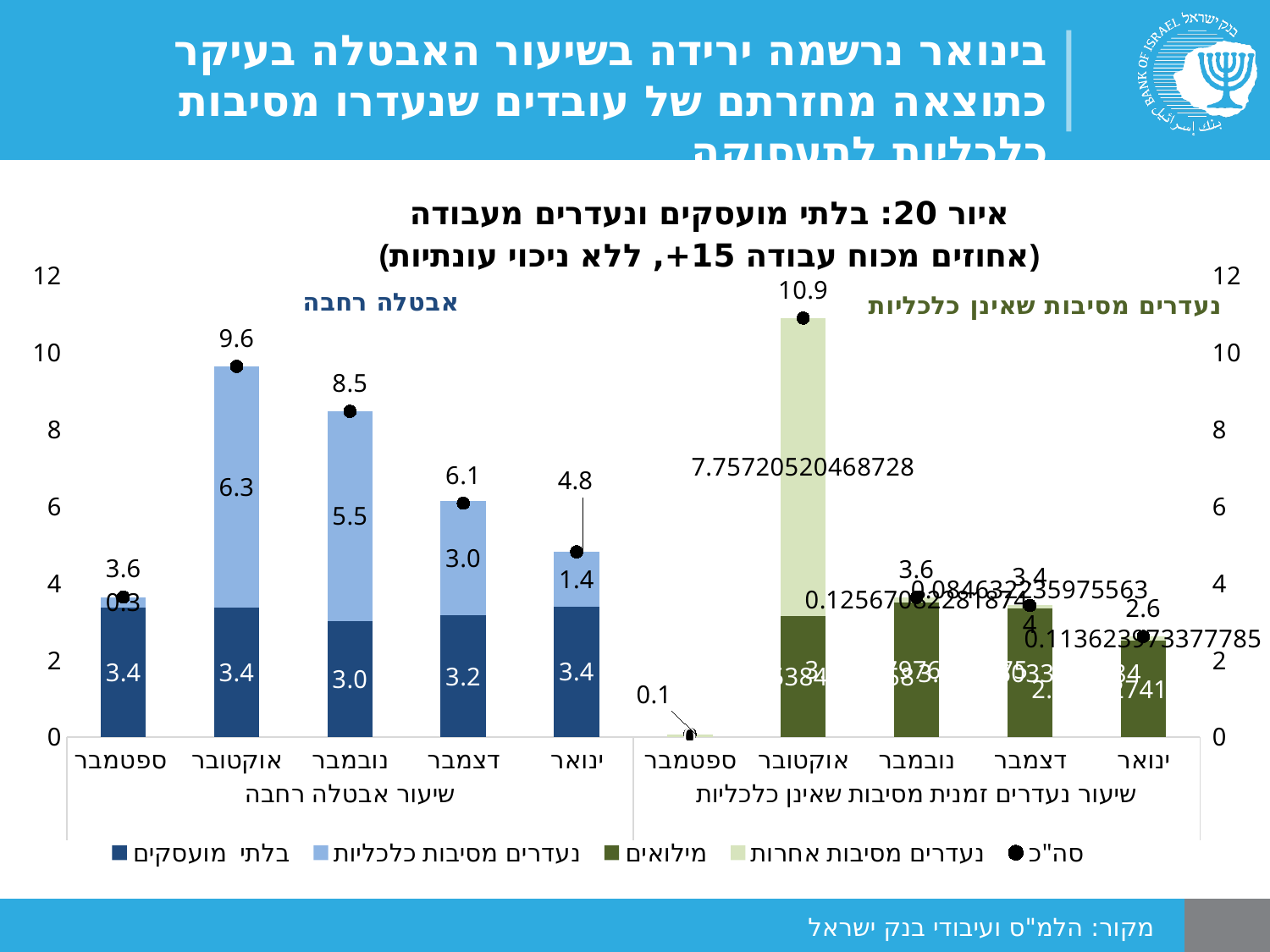
What is the בלתי מועסקים value for נובמבר in the שיעור אבטלה רחבה group? 3.0 How many series does the legend list? 5 Which month has the lowest total in the שיעור נעדרים זמנית מסיבות שאינן כלכליות group? ספטמבר Does the total for the שיעור אבטלה רחבה group rise or fall from אוקטובר to ינואר? fall What is the total (סה"כ) value for אוקטובר in the שיעור נעדרים זמנית מסיבות שאינן כלכליות group? 10.9 Which month has the highest total in the שיעור אבטלה רחבה group? אוקטובר In the שיעור אבטלה רחבה group, which is larger: the total for דצמבר or the total for ינואר? דצמבר What is the difference between the totals for אוקטובר and ינואר in the שיעור אבטלה רחבה group? 4.8 What is the total (סה"כ) value for אוקטובר in the שיעור אבטלה רחבה group? 9.6 What kind of chart is shown on the slide? stacked bar chart What is the נעדרים מסיבות כלכליות value for דצמבר in the שיעור אבטלה רחבה group? 3.0 What is the figure number given in the chart title? איור 20